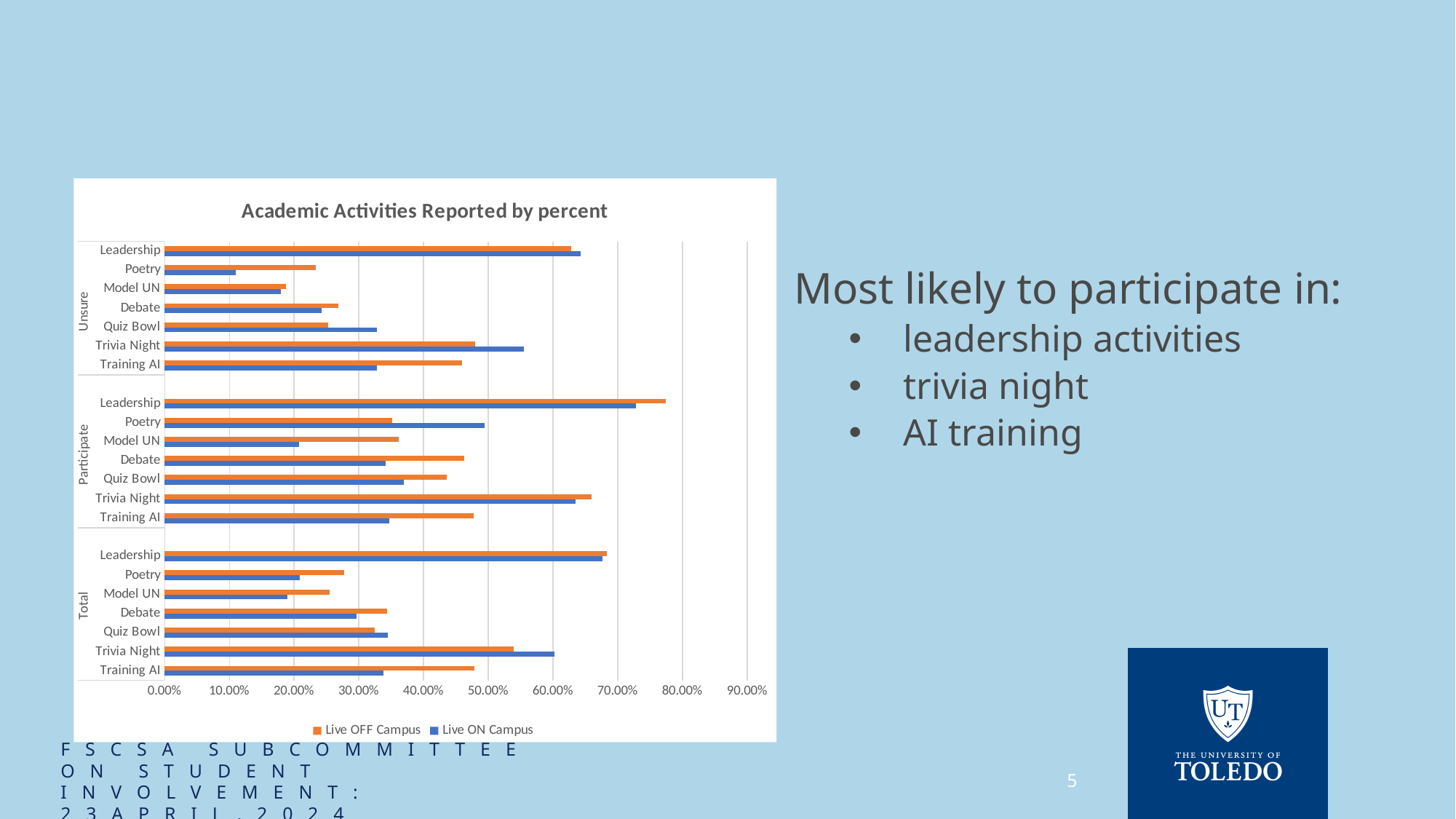
In the Participate group, which is larger for Poetry: Live OFF Campus or Live ON Campus? Live ON Campus Is the Live OFF Campus value for Training AI in the Total group greater or less than 40.00%? greater How many series does the legend list? 2 What are the two series named in the legend? Live OFF Campus and Live ON Campus In the Unsure group, which activity has the lowest Live ON Campus value? Poetry In the Participate group, which is larger for Model UN: Live OFF Campus or Live ON Campus? Live OFF Campus How many activities are listed within each group (Unsure, Participate, Total)? 7 In the Participate group, which activity has the highest Live OFF Campus value? Leadership What is the title of the chart? Academic Activities Reported by percent Is the Live ON Campus value for Poetry in the Unsure group greater or less than 20.00%? less What type of chart is shown on the slide? bar chart Is the Live OFF Campus value for Leadership in the Participate group greater or less than 70.00%? greater